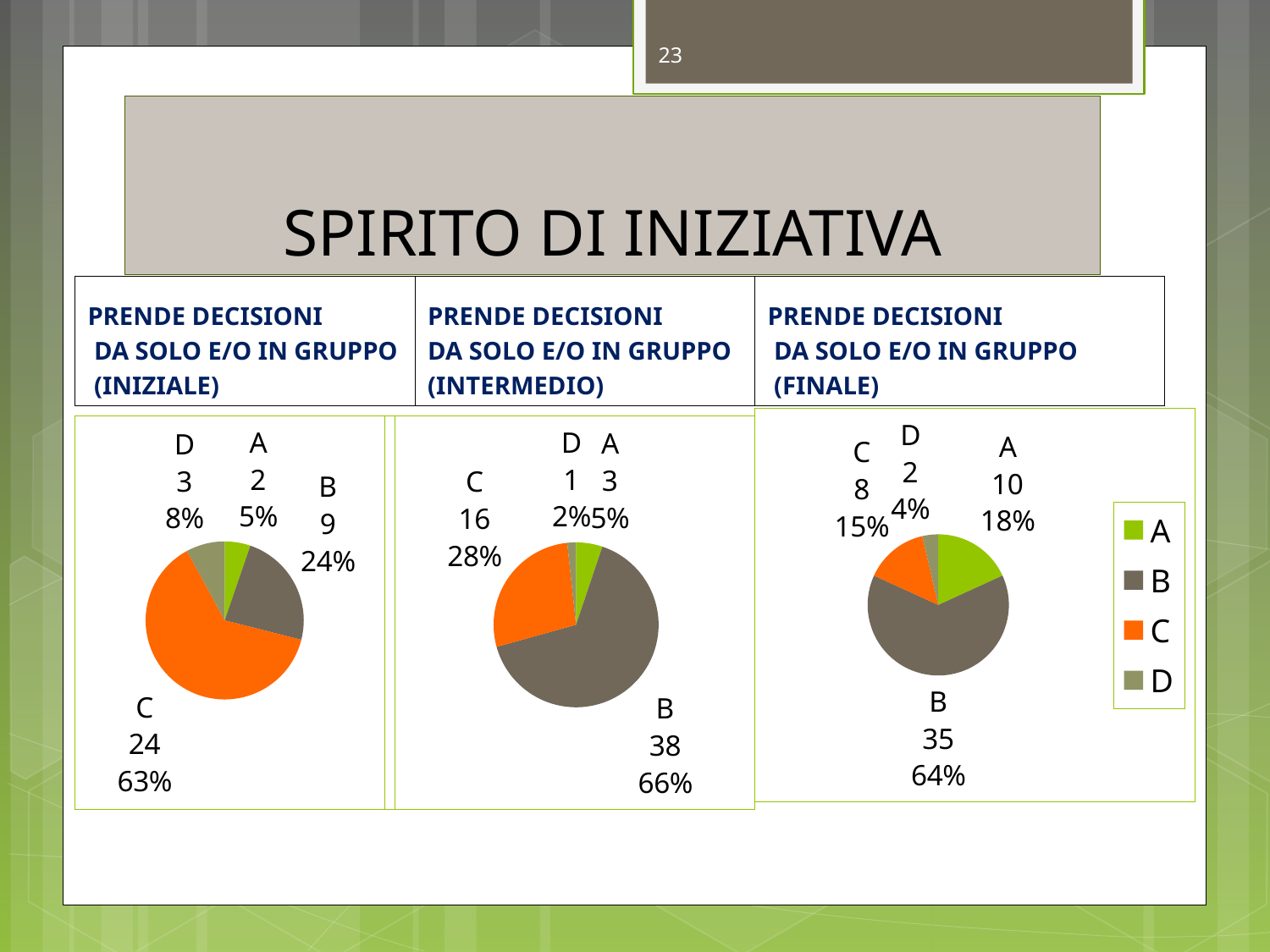
In the INTERMEDIO chart, what is the difference between the values for B and C? 22 In the FINALE chart, what is the value for category B? 35 How many categories does the legend on the right list? 4 In the legend, which colour represents category C? Orange In the INTERMEDIO chart, what is the value for category B? 38 In the INIZIALE chart, what percentage share does category B have? 24% What type of chart is used in the INIZIALE, INTERMEDIO and FINALE panels? Pie chart In the FINALE chart, what percentage share does category A have? 18% In the INTERMEDIO chart, which category has the smallest slice? D In the INIZIALE chart, which category has the largest slice? C In the INIZIALE chart, what is the value for category C? 24 In the FINALE chart, which is larger, the value for A or the value for C? A